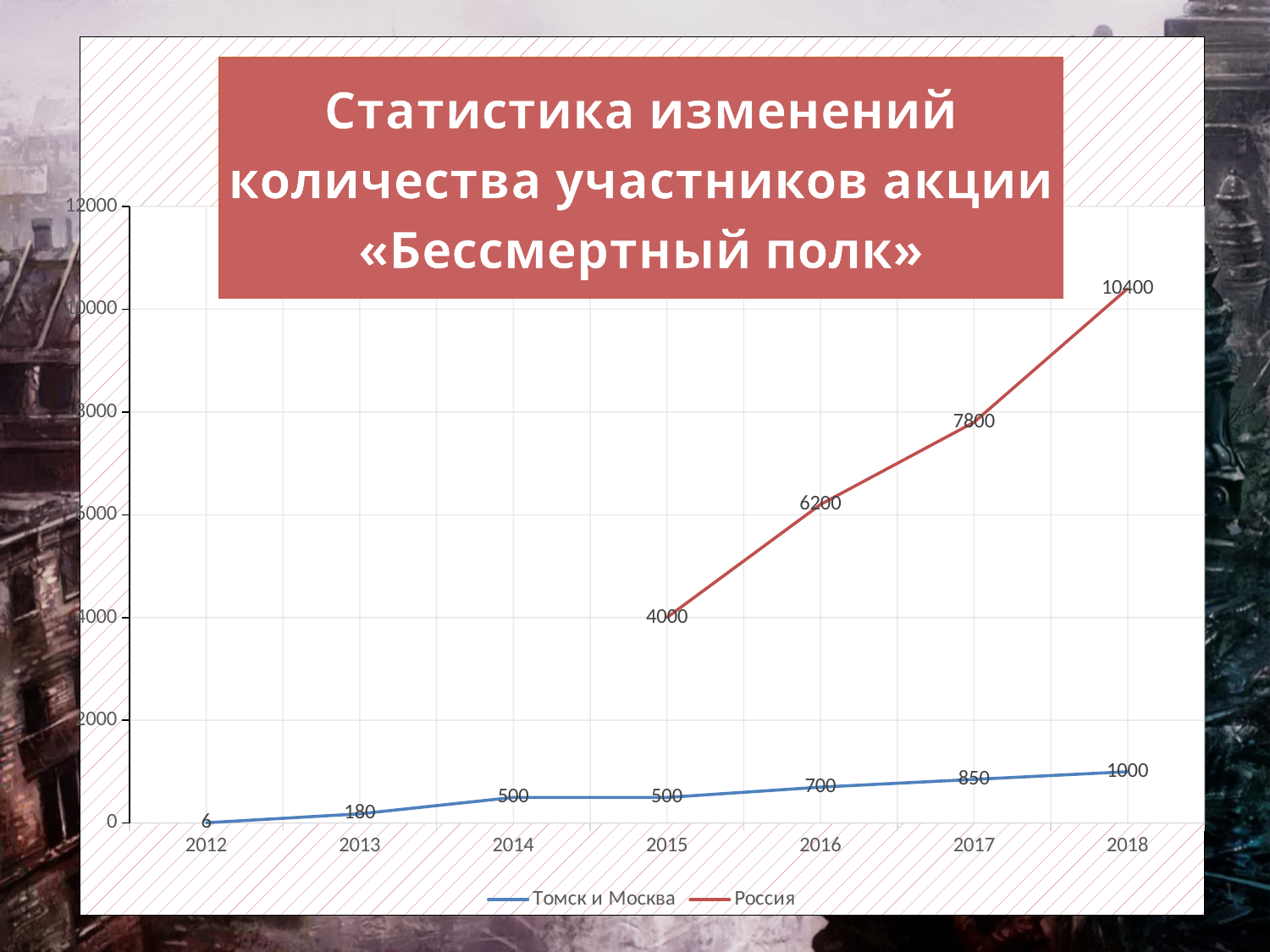
What is the difference between the Томск и Москва values for 2018 and 2017? 150 What is the value for Россия in 2015? 4000 How many years are shown on the x axis? 7 What is the difference between the Россия values for 2018 and 2017? 2600 Does the Россия series rise or fall from 2015 to 2018? rise What is the value for Томск и Москва in 2013? 180 What is the value for Россия in 2018? 10400 Which is larger in 2016: the value for Россия or the value for Томск и Москва? Россия In which year is the value for Томск и Москва highest? 2018 How many series does the legend list? 2 What type of chart is shown on the slide? line chart In which year is the value for Томск и Москва lowest? 2012